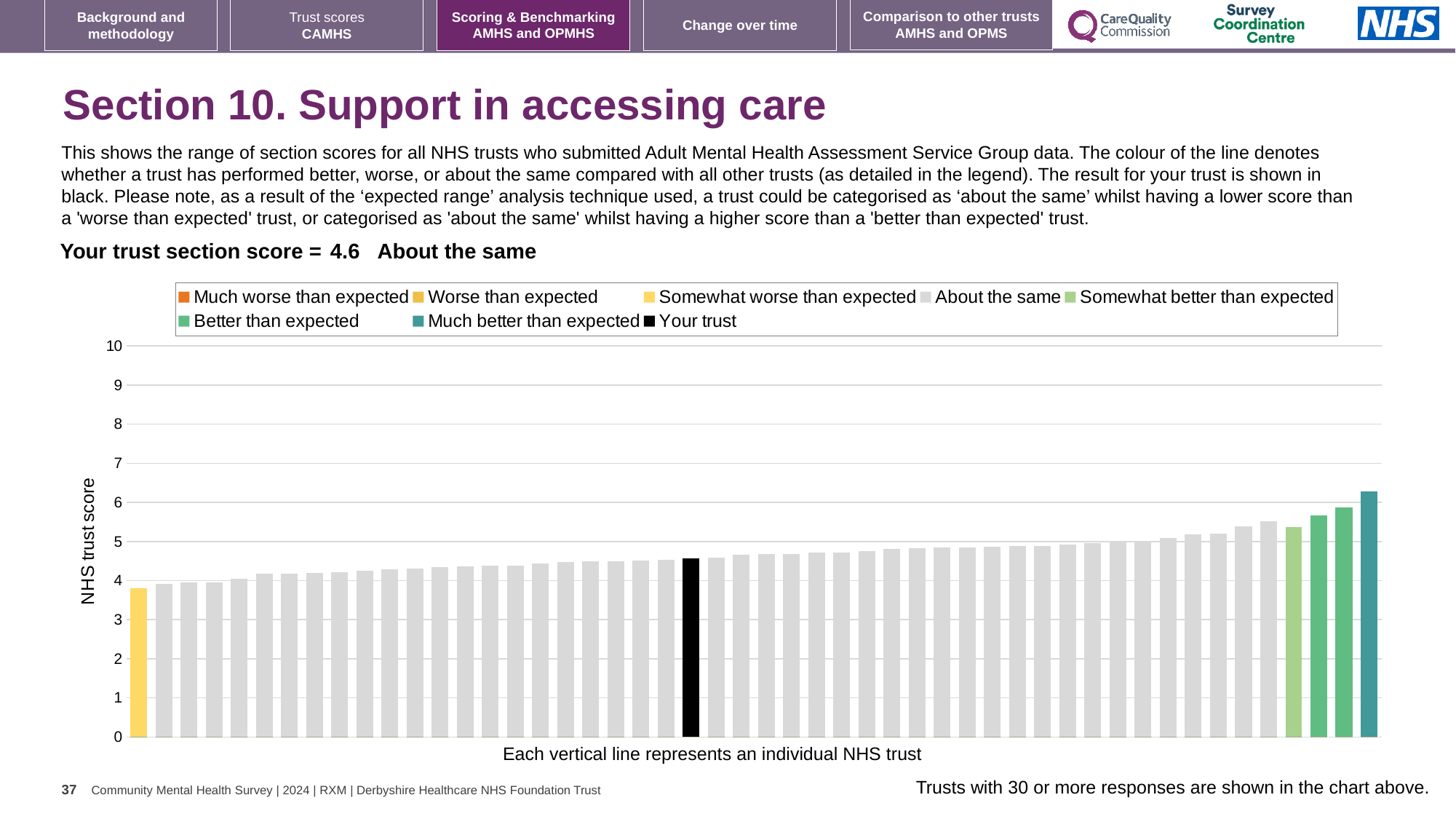
What colour is the bar representing your trust? black What is the label on the y axis? NHS trust score How many bars are coloured teal (Much better than expected)? 1 Do the bar values rise or fall from left to right along the x axis? rise How many entries does the chart legend list? 8 Is the value of the tallest bar greater or less than 6? greater Which legend category does the tallest bar belong to? Much better than expected Is the value for your trust (the black bar) greater or less than 4? greater What is the section score for your trust? 4.6 Is the value of the shortest bar greater or less than 4? less What kind of chart is shown on the slide? bar chart